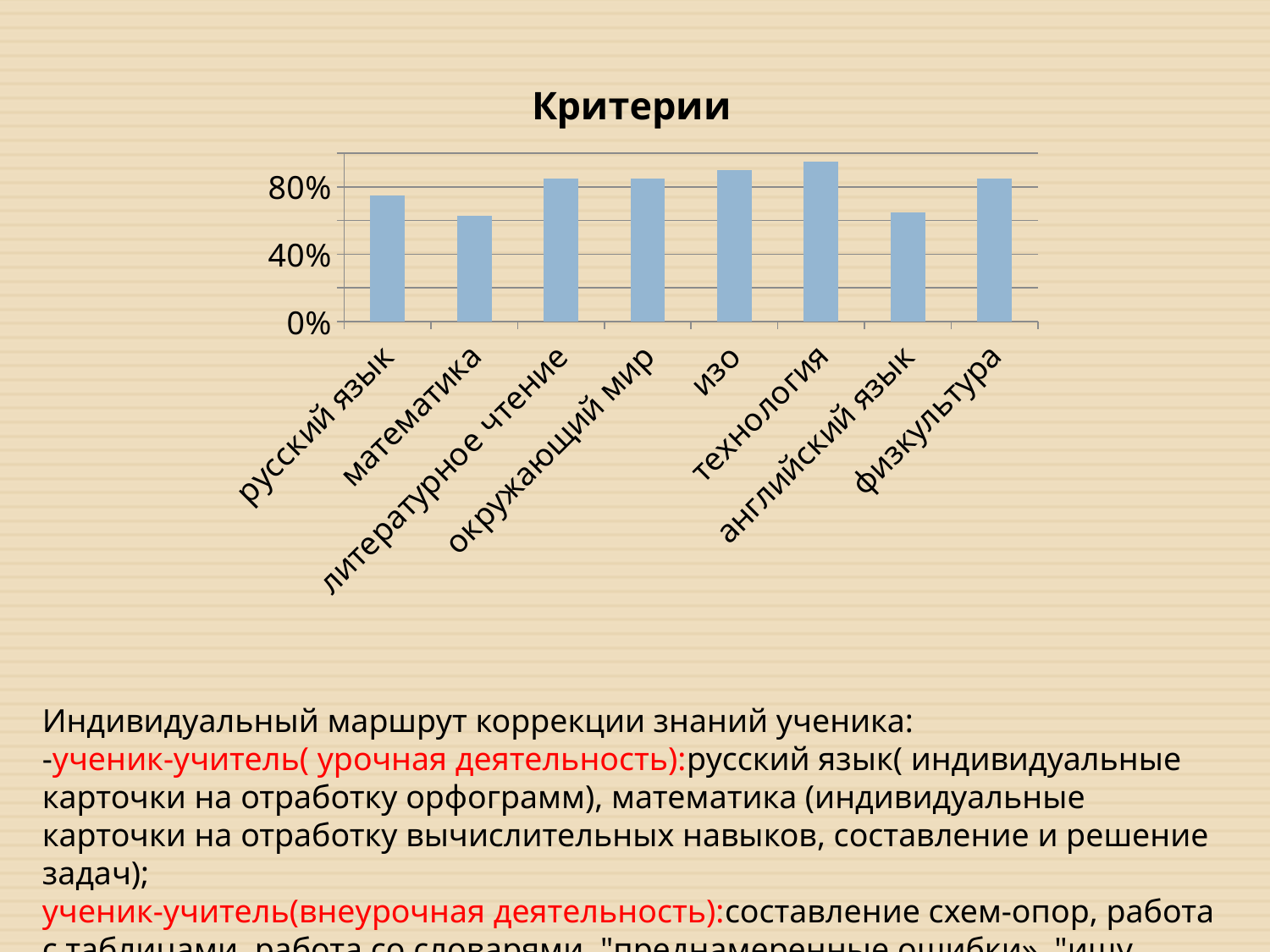
Which is larger, the value for технология or the value for математика? технология How many categories are shown on the x axis of the chart? 8 What type of chart is shown on the slide? bar chart What is the title of the chart? Критерии What colour are the bars in the chart? blue Which category has the highest bar in the chart? технология Is the value for русский язык greater or less than 80%? less Is the value for изо greater or less than 80%? greater Is the value for английский язык greater or less than 40%? greater Which is larger, the value for изо or the value for русский язык? изо